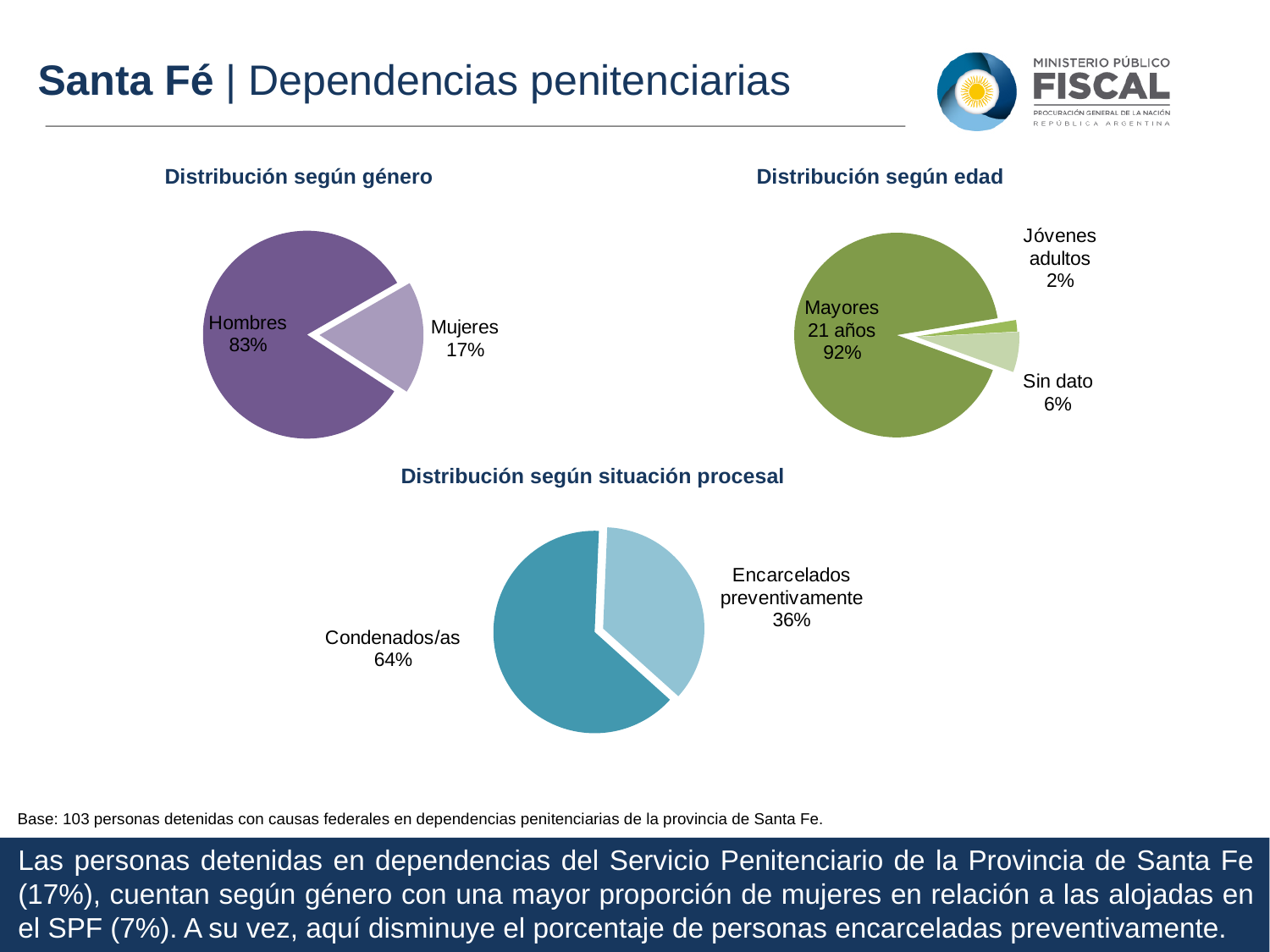
In the 'Distribución según género' chart, what share is Mujeres? 17% In the 'Distribución según edad' chart, which category has the smallest slice? Jóvenes adultos How many categories does the 'Distribución según edad' chart show? 3 In the 'Distribución según situación procesal' chart, what share is Encarcelados preventivamente? 36% In the 'Distribución según edad' chart, what share is Sin dato? 6% In the 'Distribución según situación procesal' chart, what is the difference between Condenados/as and Encarcelados preventivamente? 28% In the 'Distribución según género' chart, what share is Hombres? 83% What kind of chart is 'Distribución según situación procesal'? Pie chart In the 'Distribución según edad' chart, what share is Mayores 21 años? 92% In the 'Distribución según género' chart, which is larger, Hombres or Mujeres? Hombres In the 'Distribución según situación procesal' chart, what share is Condenados/as? 64% How many charts are on the slide? 3